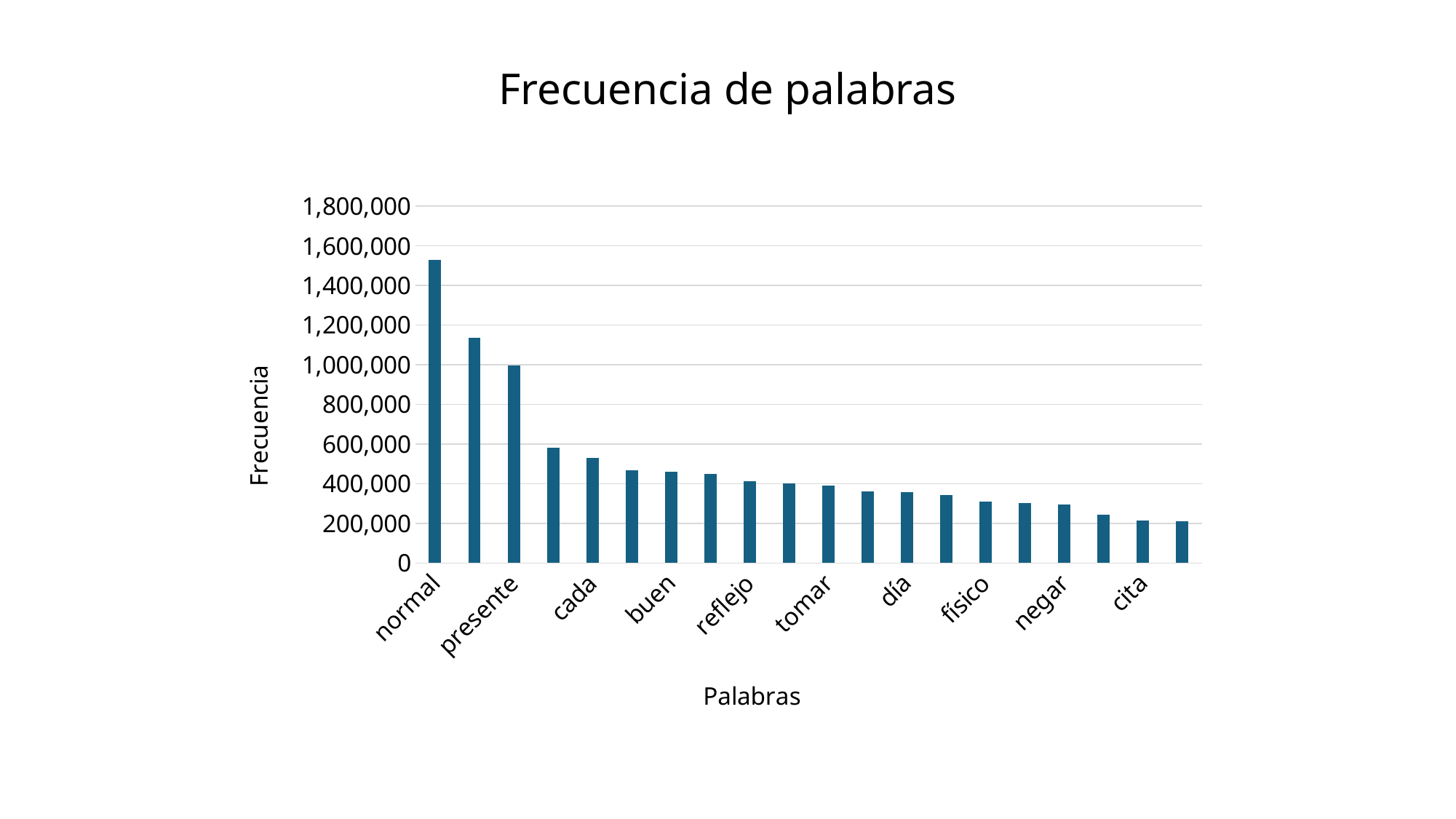
What is the label of the vertical axis? Frecuencia What kind of chart is shown on the slide? bar chart Is the value for físico greater or less than 400,000? less Is the value for cita greater or less than 400,000? less How many bars are plotted in the chart? 20 Which word has the highest frequency? normal What is the title of the chart? Frecuencia de palabras Do the values rise or fall from left to right along the x axis? fall Is the value for cada greater or less than 600,000? less Which has a higher frequency, normal or presente? normal Which has a higher frequency, cada or negar? cada